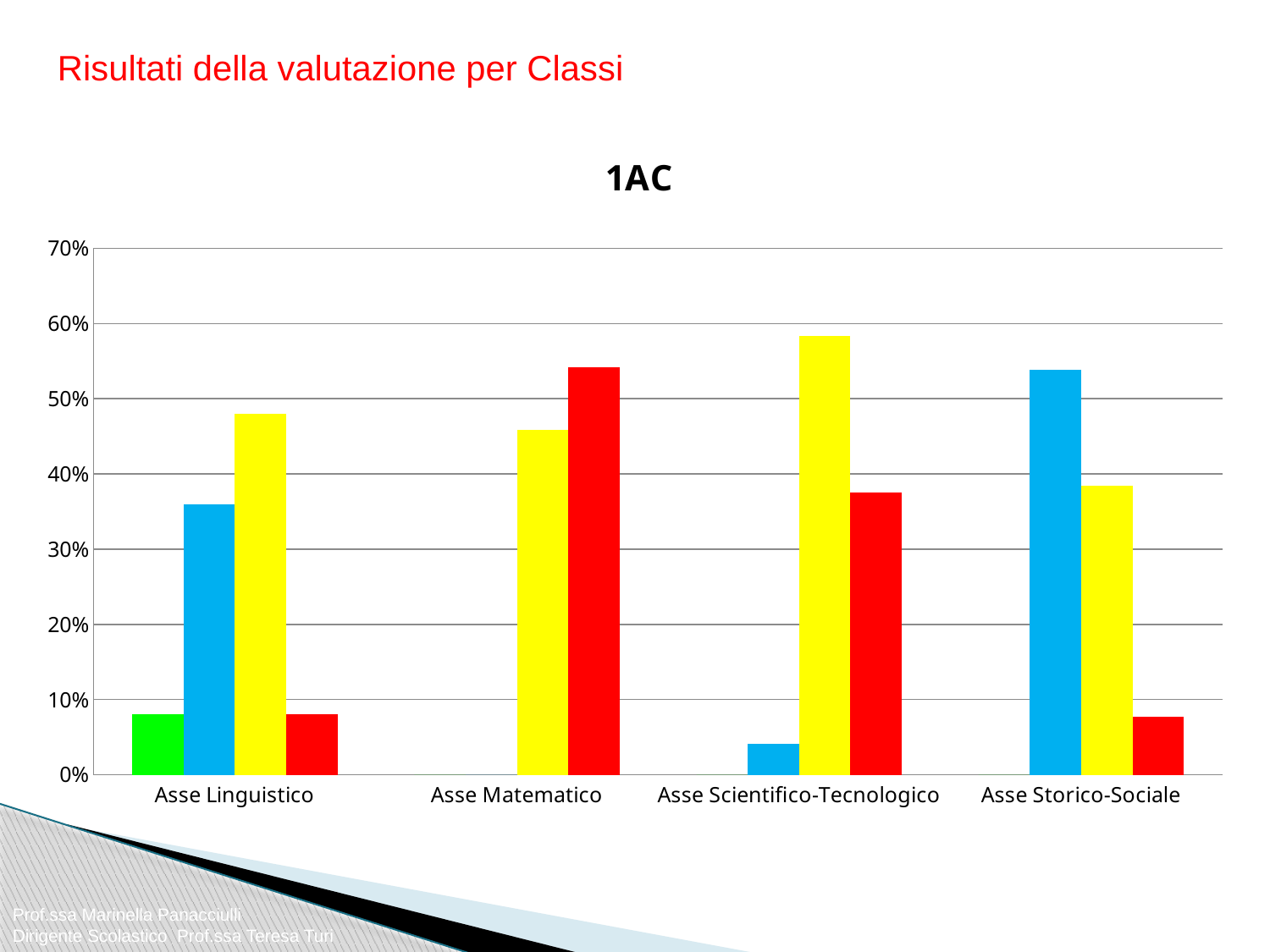
Is the yellow bar for Asse Scientifico-Tecnologico greater or less than 50%? greater Which category has the tallest red bar? Asse Matematico Which category has the tallest yellow bar? Asse Scientifico-Tecnologico What is the title of the chart? 1AC What kind of chart is shown on the slide? bar chart Is the red bar for Asse Matematico greater or less than 50%? greater Is the blue bar for Asse Linguistico greater or less than 40%? less For Asse Storico-Sociale, which is larger, the blue bar or the yellow bar? the blue bar How many categories are shown on the x axis of the chart? 4 Which category has the shortest blue bar? Asse Scientifico-Tecnologico Which category is the only one with a green bar? Asse Linguistico